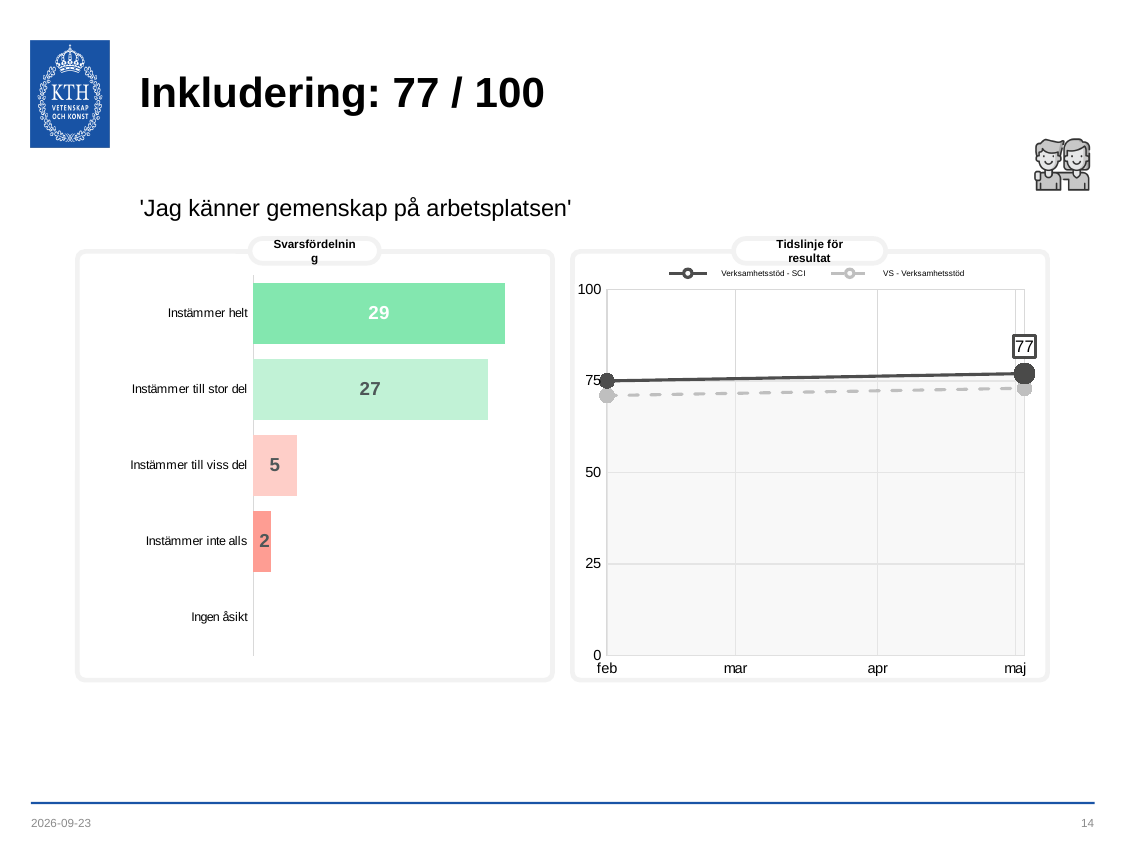
In the Tidslinje för resultat chart, is the value for 'Verksamhetsstöd - SCI' in feb greater or less than 50? greater In the Svarsfördelning chart, what is the value for 'Instämmer helt'? 29 How many series does the legend of the Tidslinje för resultat chart list? 2 What kind of chart is the Svarsfördelning chart? Bar chart In the Svarsfördelning chart, which is larger: 'Instämmer till viss del' or 'Instämmer inte alls'? Instämmer till viss del In the Svarsfördelning chart, what is the value for 'Instämmer inte alls'? 2 In the Svarsfördelning chart, which category has the highest value? Instämmer helt In the Svarsfördelning chart, what is the difference between 'Instämmer till stor del' and 'Instämmer till viss del'? 22 How many categories are listed in the Svarsfördelning chart? 5 In the Svarsfördelning chart, what is the value for 'Instämmer till viss del'? 5 In the Tidslinje för resultat chart, what is the value for 'Verksamhetsstöd - SCI' in maj? 77 In the Svarsfördelning chart, what is the difference between 'Instämmer helt' and 'Instämmer till stor del'? 2